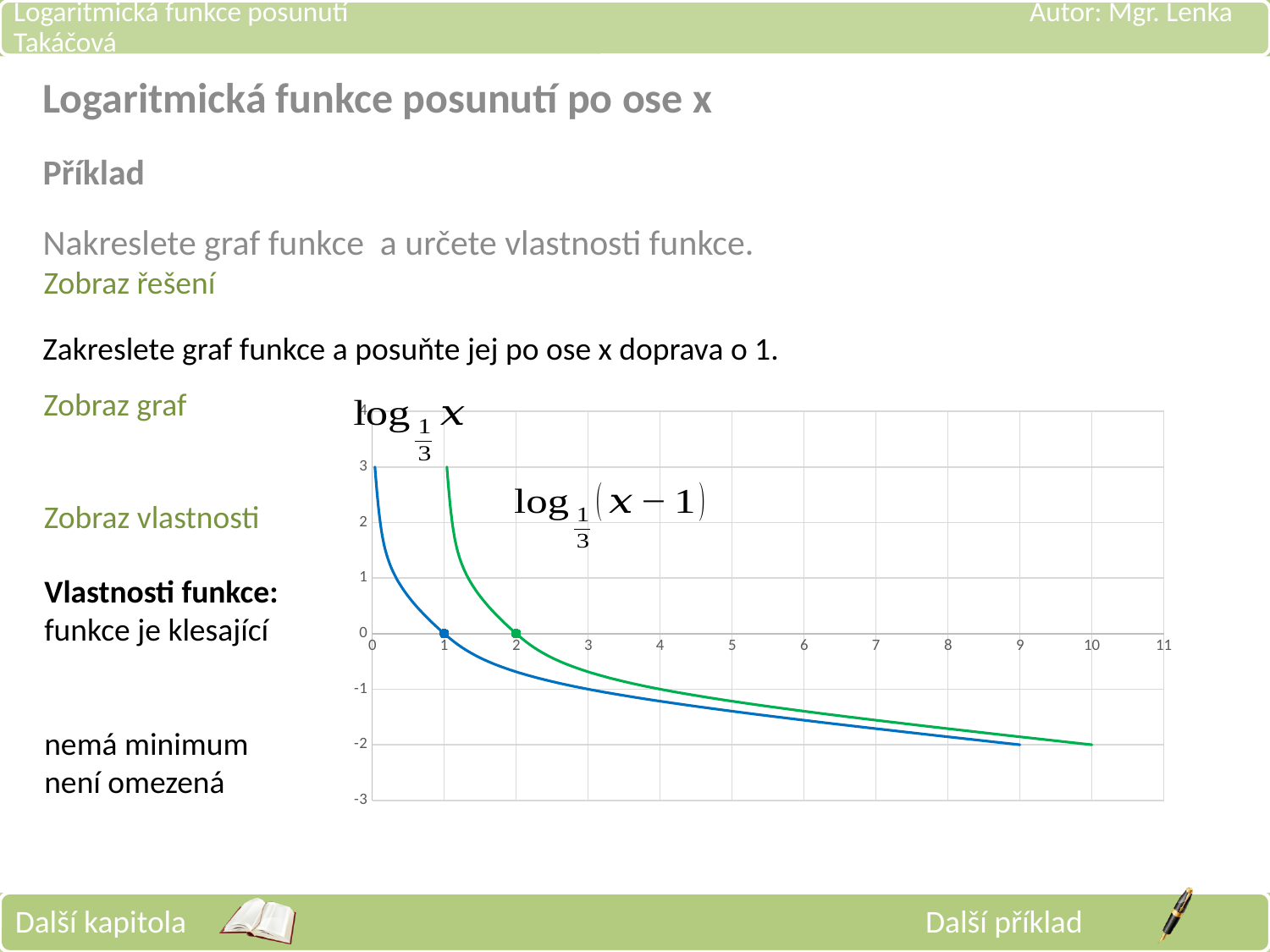
At x = 5, which curve has the higher y value, the blue one or the green one? green Is the y value of the green curve at x = 1.5 greater or less than 1? less At which x value does the blue curve cross the x axis (y = 0)? 1 What is the y value of the green curve at x = 4? -1 What is the highest value labelled on the y axis? 4 How many curves (series) are plotted on the chart? 2 Which function label is written next to the green curve? log₁/₃(x − 1) Is the y value of the blue curve at x = 6 greater or less than 0? less What kind of chart is shown on the slide? line chart What is the y value of the blue curve at x = 3? -1 Do the values of the blue curve rise or fall as x increases? fall At which x value does the green curve cross the x axis (y = 0)? 2